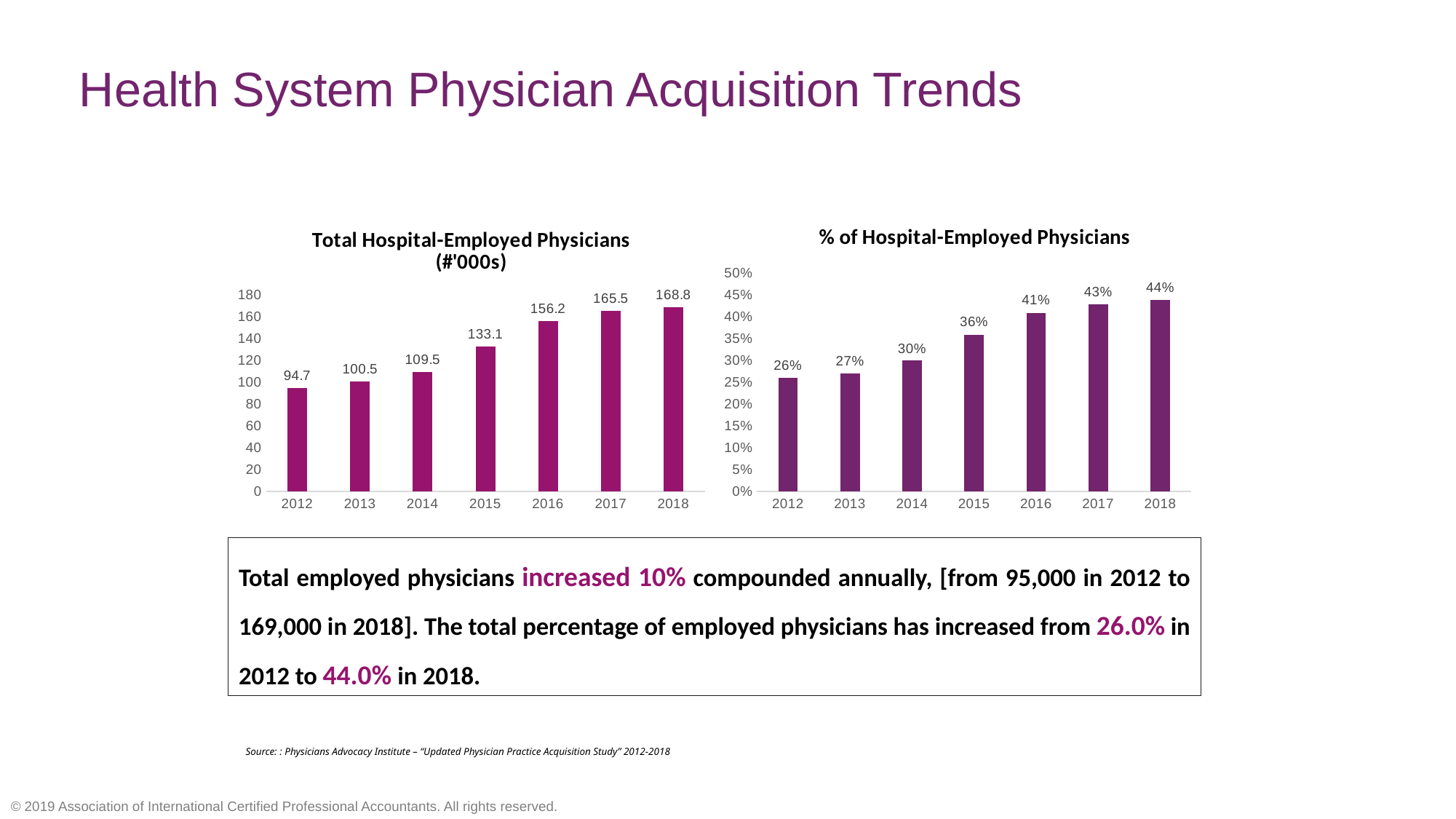
In the '% of Hospital-Employed Physicians' chart, what is the value for 2016? 41% In the 'Total Hospital-Employed Physicians (#'000s)' chart, which year has the highest value? 2018 In the '% of Hospital-Employed Physicians' chart, what is the difference between the 2015 and 2014 values? 6% In the 'Total Hospital-Employed Physicians (#'000s)' chart, is the value for 2013 greater or less than 120? less What kind of chart is the 'Total Hospital-Employed Physicians (#'000s)' chart? bar chart What is the title of the chart on the right side of the slide? % of Hospital-Employed Physicians In the 'Total Hospital-Employed Physicians (#'000s)' chart, what is the value for 2015? 133.1 In the '% of Hospital-Employed Physicians' chart, do the values rise or fall from 2012 to 2018? rise In the 'Total Hospital-Employed Physicians (#'000s)' chart, what is the difference between the 2018 and 2012 values? 74.1 How many years are shown on the x axis of the '% of Hospital-Employed Physicians' chart? 7 In the '% of Hospital-Employed Physicians' chart, which year has the lowest value? 2012 In the 'Total Hospital-Employed Physicians (#'000s)' chart, which is larger, the value for 2014 or the value for 2016? 2016